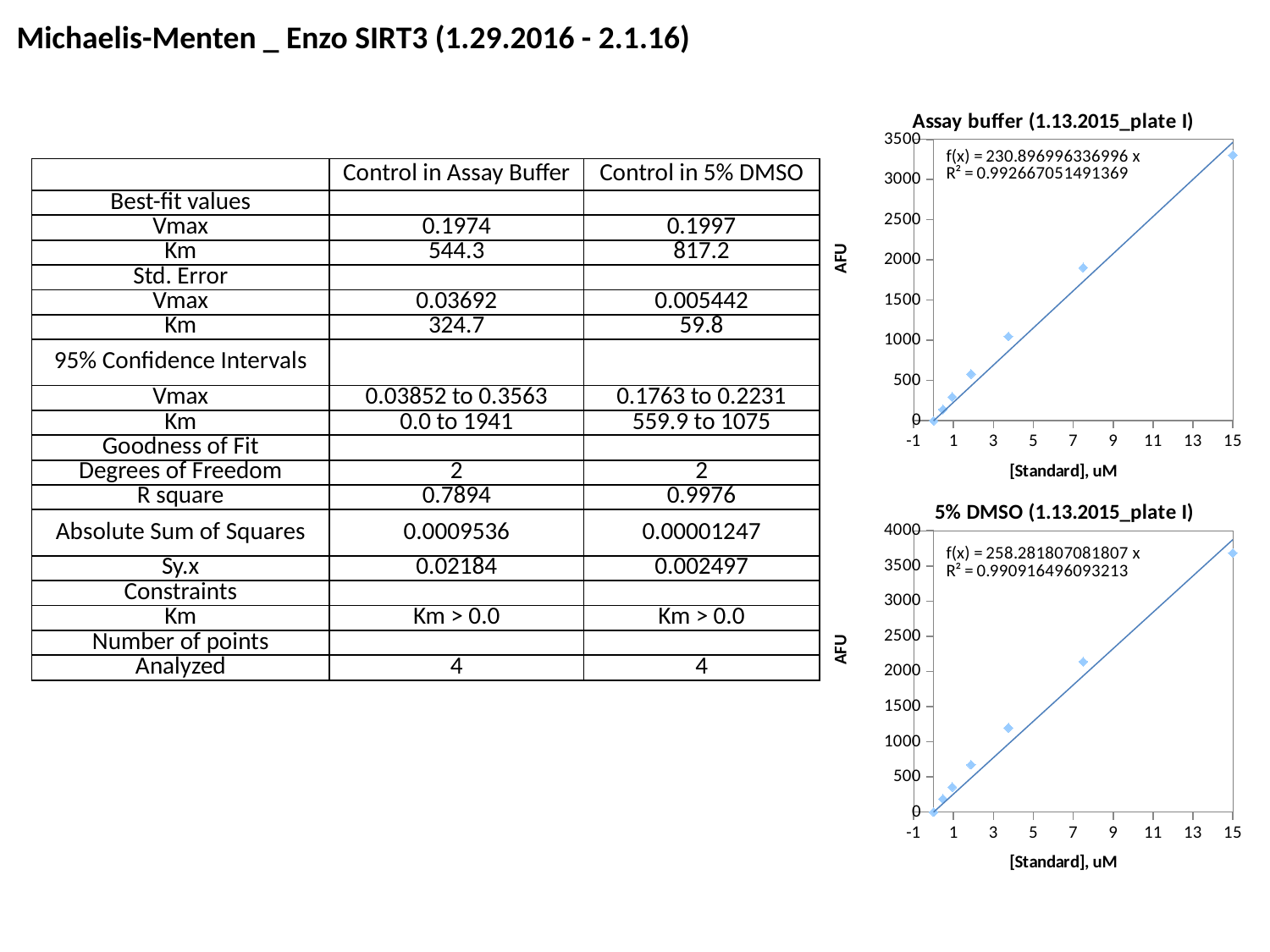
What is the trendline equation shown on the 'Assay buffer (1.13.2015_plate I)' chart? f(x) = 230.896996336996 x In the '5% DMSO (1.13.2015_plate I)' chart, is the AFU value at about 7.5 uM greater or less than 2500? less In the '5% DMSO (1.13.2015_plate I)' chart, is the AFU value at about 3.75 uM greater or less than 1000? greater What kind of chart is the 'Assay buffer (1.13.2015_plate I)' chart? scatter chart In the 'Assay buffer (1.13.2015_plate I)' chart, is the AFU value at about 7.5 uM greater or less than 1500? greater What R² value is shown on the '5% DMSO (1.13.2015_plate I)' chart? R² = 0.990916496093213 In the '5% DMSO (1.13.2015_plate I)' chart, do the AFU values rise or fall as [Standard], uM increases? rise In the 'Assay buffer (1.13.2015_plate I)' chart, do the AFU values rise or fall as [Standard], uM increases? rise Which chart has the higher AFU value at 15 uM, 'Assay buffer (1.13.2015_plate I)' or '5% DMSO (1.13.2015_plate I)'? 5% DMSO (1.13.2015_plate I)